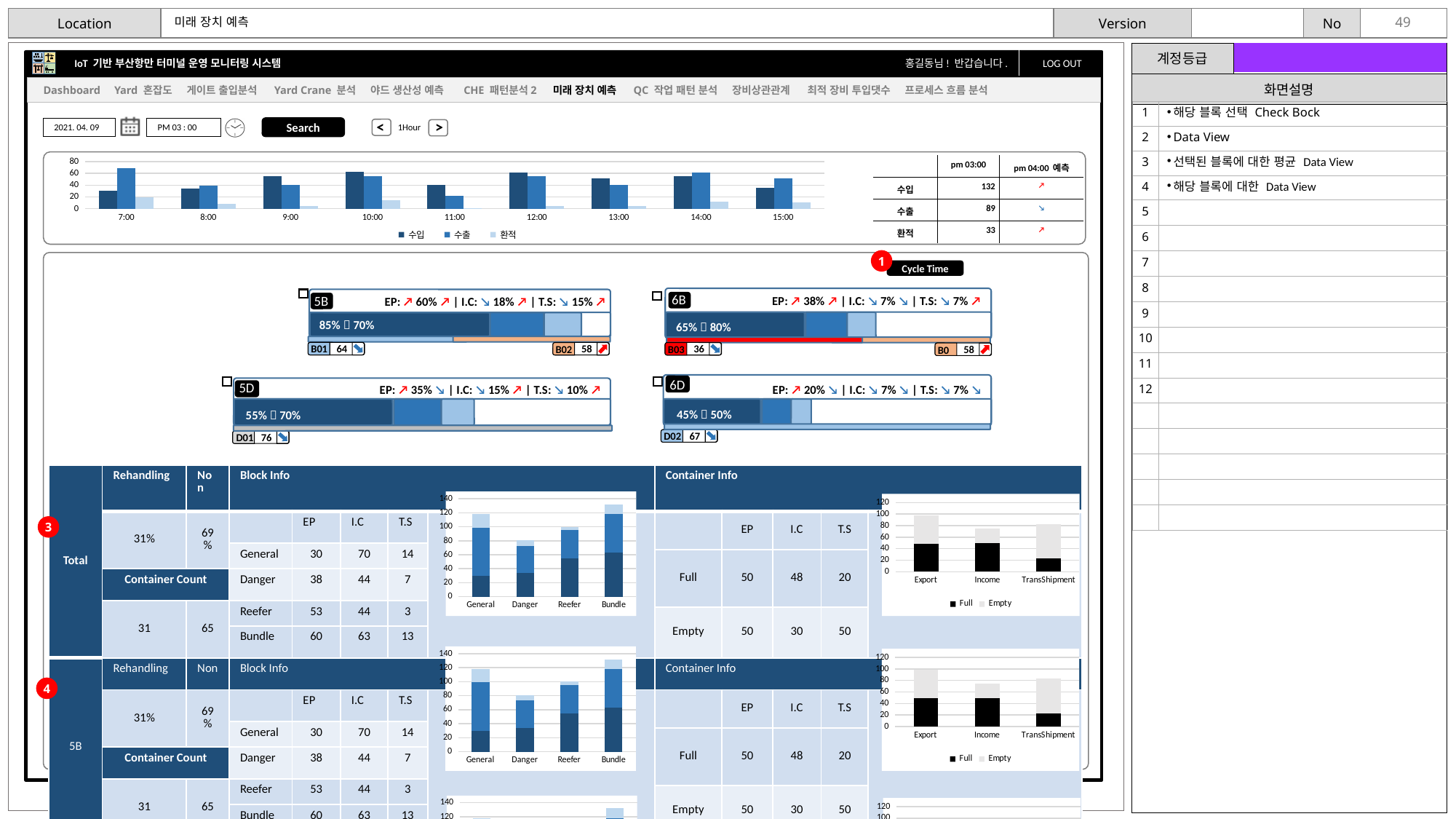
In the hourly bar chart at the top of the slide, which is larger at 7:00, 수입 or 수출? 수출 In the hourly bar chart at the top of the slide, is the value for 수출 at 7:00 greater or less than 60? greater In the hourly bar chart at the top of the slide, how many series does the legend list? 3 In the Block Info chart in the Total row, how many categories are shown on the x axis? 4 What kind of chart is the hourly chart at the top of the slide? bar chart In the hourly bar chart at the top of the slide, is the value for 환적 at 7:00 greater or less than 40? less In the Container Info chart in the Total row, which category has the tallest stacked bar? Export In the hourly bar chart at the top of the slide, which is larger at 9:00, 수입 or 수출? 수입 In the hourly bar chart at the top of the slide, how many time categories are shown on the x axis? 9 In the Container Info chart in the Total row, how many series does the legend list? 2 In the Container Info chart in the Total row, is the Full value for TransShipment greater or less than 40? less In the Block Info chart in the Total row, which category has the tallest stacked bar? Bundle